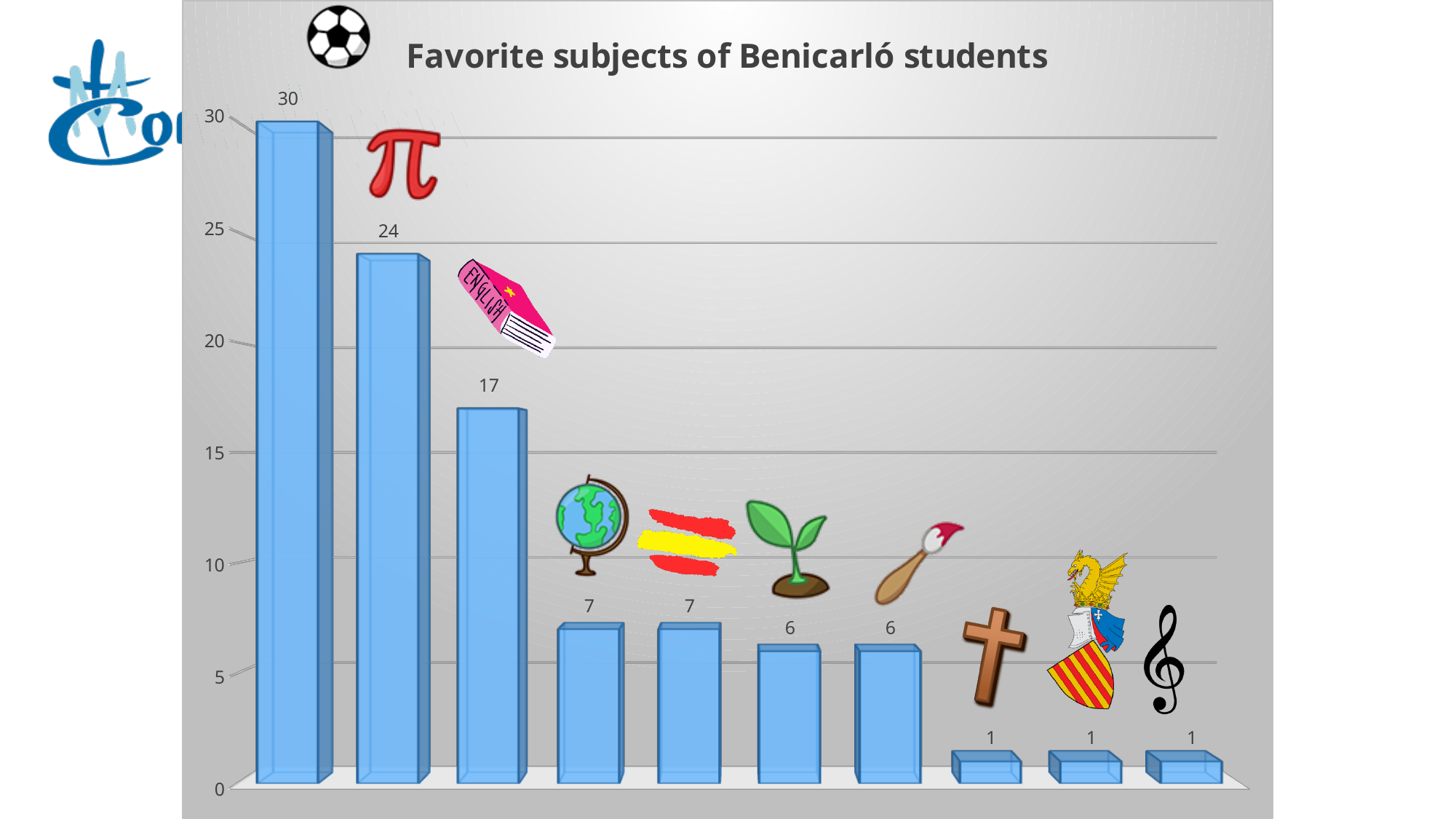
What is the difference between the first bar (30) and the second bar (24)? 6 Do the bar values rise or fall from left to right across the chart? fall What kind of chart is shown on the slide? bar chart What is the value of the tallest bar (the first bar from the left)? 30 What is the title of the chart? Favorite subjects of Benicarló students Which is larger, the second bar from the left or the third bar from the left? the second bar What is the value of the last bar on the right? 1 How many bars does the chart have? 10 What is the value of the sixth bar from the left? 6 What is the value of the fourth bar from the left? 7 What is the value of the third bar from the left? 17 What is the value of the second bar from the left? 24